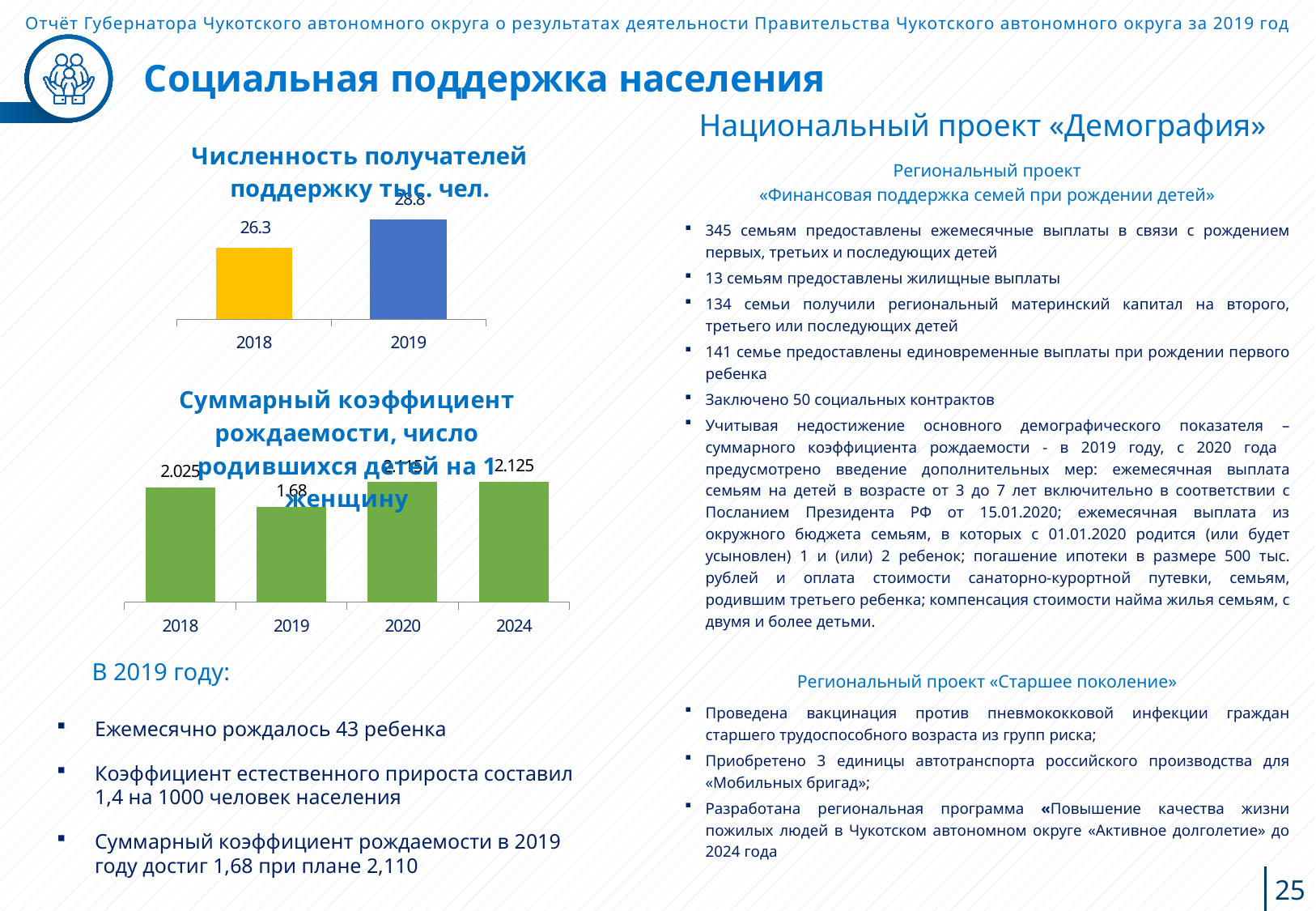
In the chart 'Суммарный коэффициент рождаемости', what is the value for 2019? 1.68 In the chart 'Численность получателей поддержку тыс. чел.', by how much does the 2019 value exceed the 2018 value? 2.5 In the chart 'Численность получателей поддержку тыс. чел.', how many bars are shown? 2 In the chart 'Суммарный коэффициент рождаемости', how many years are shown on the x axis? 4 In the chart 'Суммарный коэффициент рождаемости', what is the value for 2024? 2.125 In the chart 'Численность получателей поддержку тыс. чел.', what is the value for 2018? 26.3 In the chart 'Численность получателей поддержку тыс. чел.', what is the value for 2019? 28.8 In the chart 'Численность получателей поддержку тыс. чел.', which year has the higher value? 2019 In the chart 'Суммарный коэффициент рождаемости', what is the value for 2018? 2.025 What type of chart is 'Численность получателей поддержку тыс. чел.'? Bar chart In the chart 'Суммарный коэффициент рождаемости', which year has the lowest value? 2019 In the chart 'Суммарный коэффициент рождаемости', is the value for 2018 larger or smaller than the value for 2019? Larger